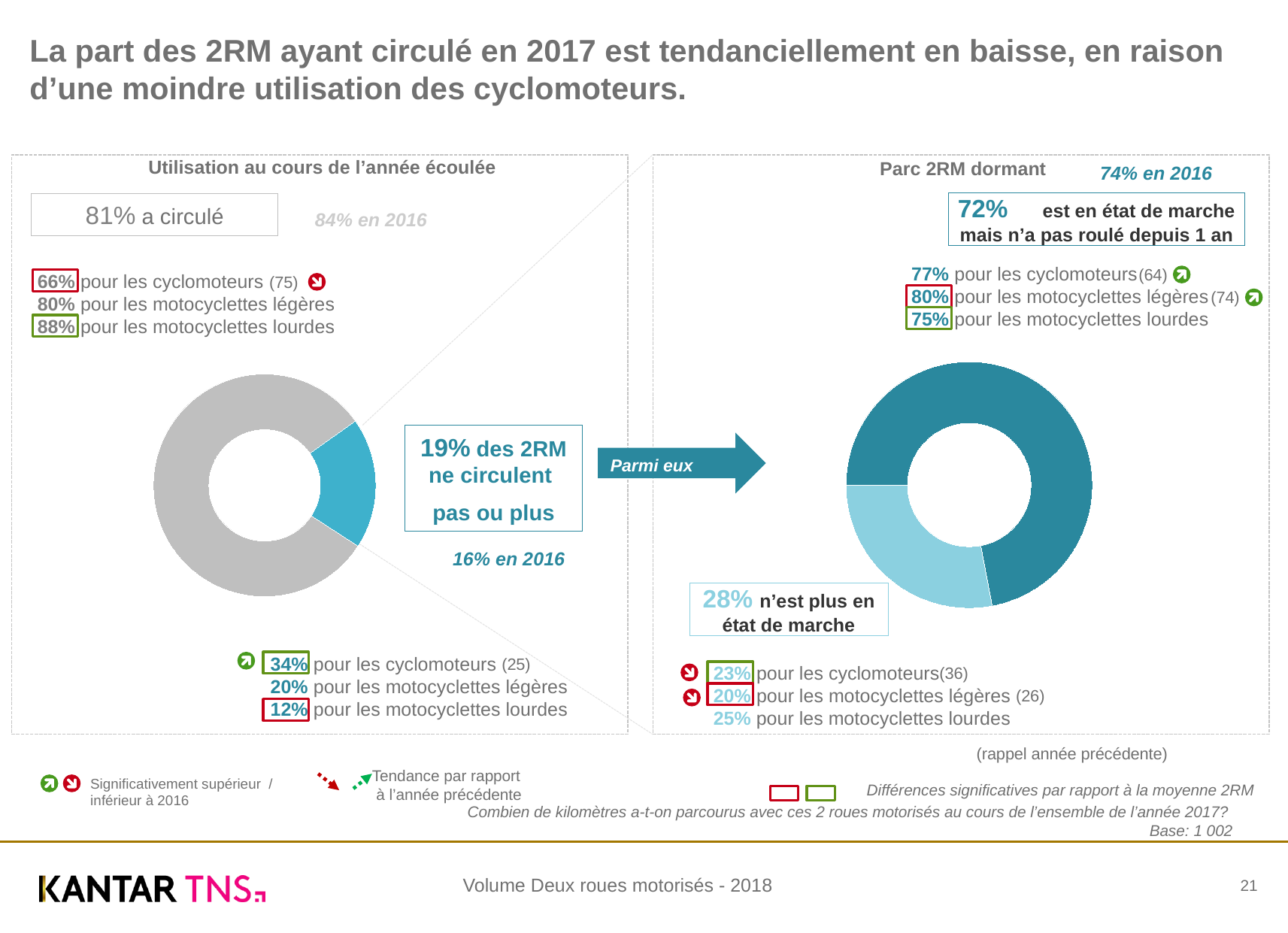
How many segments does the right chart 'Parc 2RM dormant' have? 2 In the right chart 'Parc 2RM dormant', what share n'est plus en état de marche? 28% In the left chart 'Utilisation au cours de l'année écoulée', what share of 2RM a circulé? 81% In the right chart 'Parc 2RM dormant', what share est en état de marche mais n'a pas roulé depuis 1 an? 72% In the right chart 'Parc 2RM dormant', what colour is the segment for 'n'est plus en état de marche'? Light blue In the right chart 'Parc 2RM dormant', which segment is the smallest? n'est plus en état de marche (28%) What type of chart is used on the left under 'Utilisation au cours de l'année écoulée'? Donut (pie) chart In the left chart 'Utilisation au cours de l'année écoulée', what is the difference between the share that a circulé and the share that ne circulent pas ou plus? 62 percentage points In the left chart 'Utilisation au cours de l'année écoulée', what was the share of 2RM that ne circulent pas in 2016? 16% In the right chart 'Parc 2RM dormant', what is the difference between the 72% and 28% segments? 44 percentage points In the left chart 'Utilisation au cours de l'année écoulée', which segment is larger: 'a circulé' or 'ne circulent pas ou plus'? a circulé In the left chart 'Utilisation au cours de l'année écoulée', what share of 2RM ne circulent pas ou plus? 19%